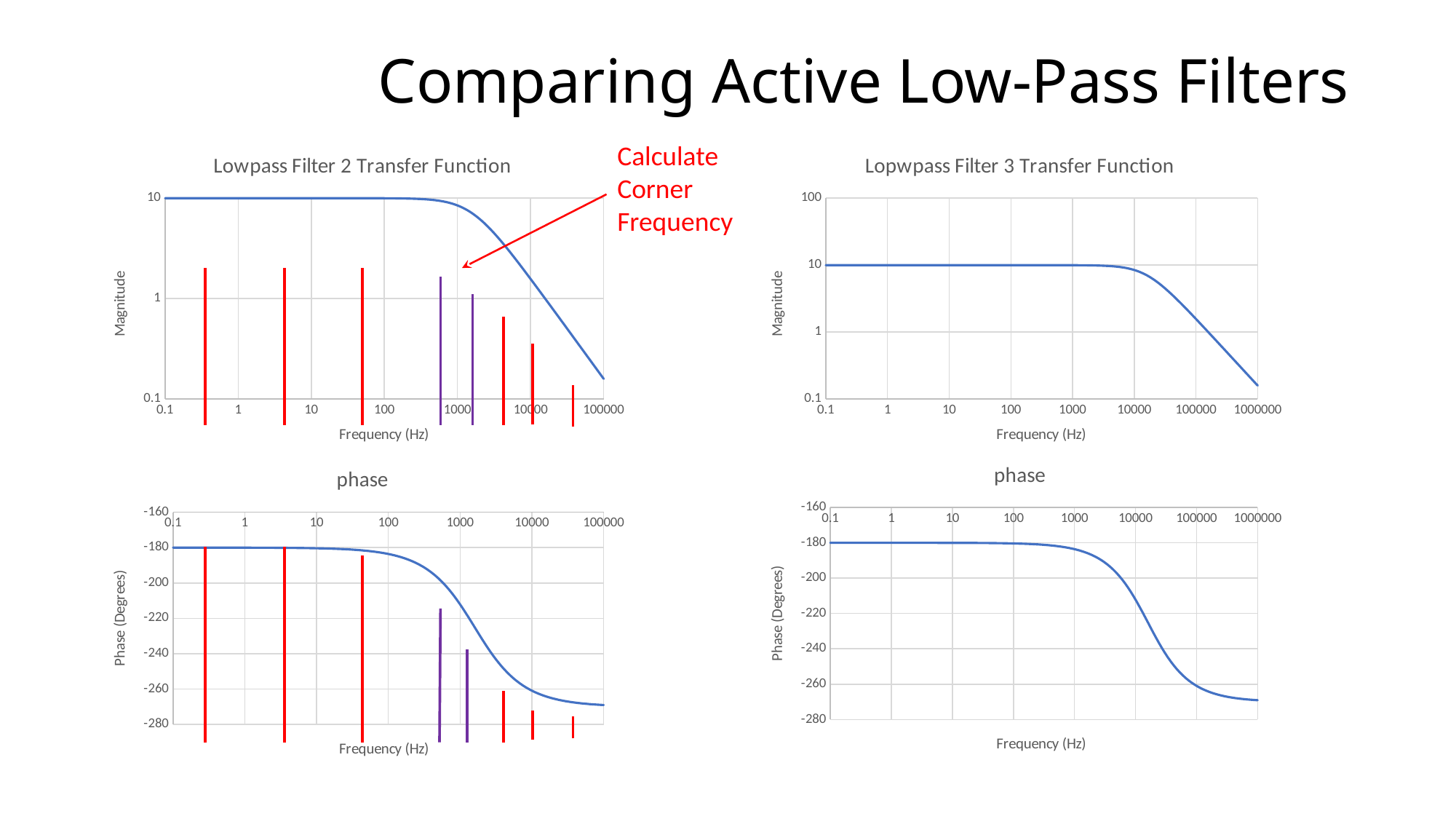
What kind of chart is the Lowpass Filter 2 Transfer Function chart? line chart In the phase chart on the left (Filter 2), is the phase at 1 Hz greater or less than -200 degrees? greater In the Lowpass Filter 2 Transfer Function chart, does the magnitude rise or fall as frequency increases beyond 1000 Hz? fall In the Lopwpass Filter 3 Transfer Function chart, is the magnitude at 100 Hz greater or less than 1? greater In the Lopwpass Filter 3 Transfer Function chart, is the magnitude at 1000000 Hz greater or less than 1? less In the phase chart on the right (Filter 3), does the phase rise or fall as frequency increases from 1000 Hz to 100000 Hz? fall How many charts are shown on the slide? 4 What is the x-axis label on the Lowpass Filter 2 Transfer Function chart? Frequency (Hz) In the Lowpass Filter 2 Transfer Function chart, which frequency has the larger magnitude, 10 Hz or 100000 Hz? 10 Hz